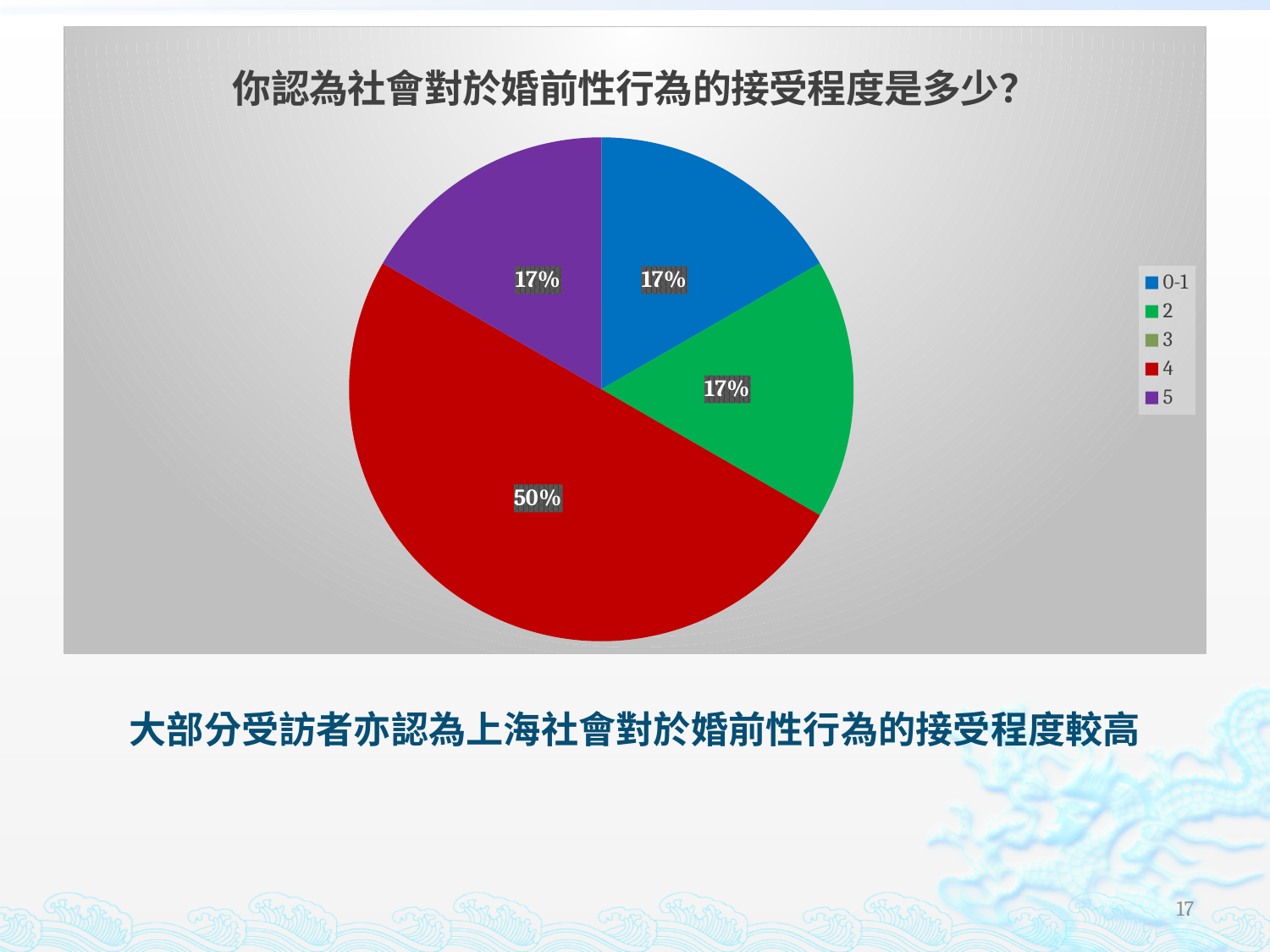
What colour is the slice for category 4? red How many entries does the legend list? 5 Which category has the largest slice of the pie? 4 What share of the pie does category 4 take? 50% What percentage of the pie is the slice for category 4? 50% What percentage is shown for category 5? 17% Which legend category has no visible slice in the pie? 3 What kind of chart is shown on the slide? pie chart What percentage is shown for the category 0-1? 17% What is the difference between the percentage for category 4 and the percentage for category 2? 33% How many slices with data labels are visible in the pie? 4 Which is larger, the slice for category 4 or the slice for category 5? 4